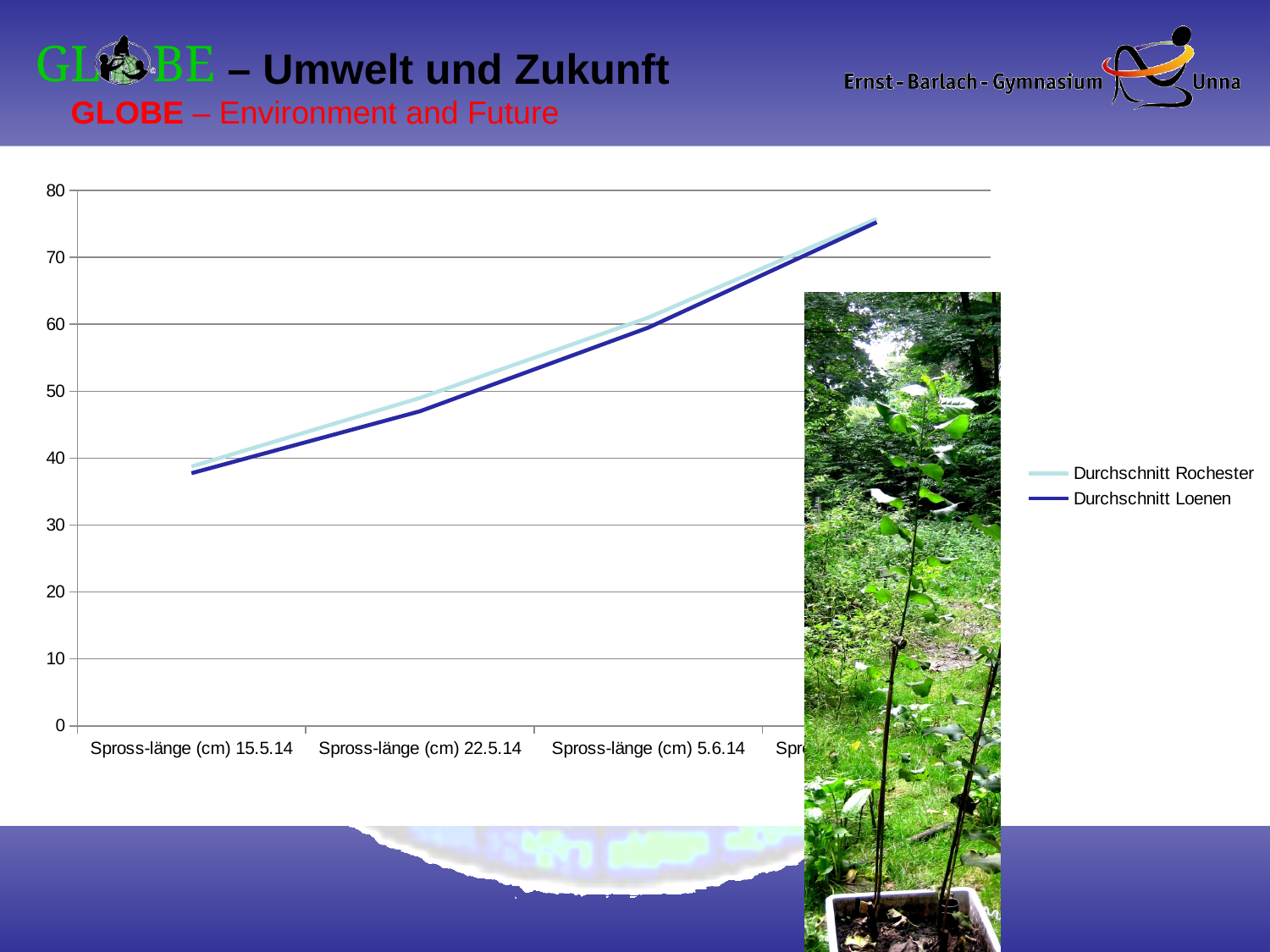
Do the values for Durchschnitt Rochester rise or fall across the measurement dates? rise How many data points does each line have? 4 Which series is drawn with the dark blue line? Durchschnitt Loenen What kind of chart is shown on the slide? line chart How many series does the legend list? 2 Is the value for Durchschnitt Loenen at Spross-länge (cm) 15.5.14 greater or less than 40? less Is the final value for Durchschnitt Rochester greater or less than 70? greater Is the value for Durchschnitt Loenen at Spross-länge (cm) 22.5.14 greater or less than 50? less At Spross-länge (cm) 22.5.14, which series has the larger value, Durchschnitt Rochester or Durchschnitt Loenen? Durchschnitt Rochester Do the values for Durchschnitt Loenen rise or fall from left to right along the x axis? rise What are the two series named in the legend? Durchschnitt Rochester and Durchschnitt Loenen